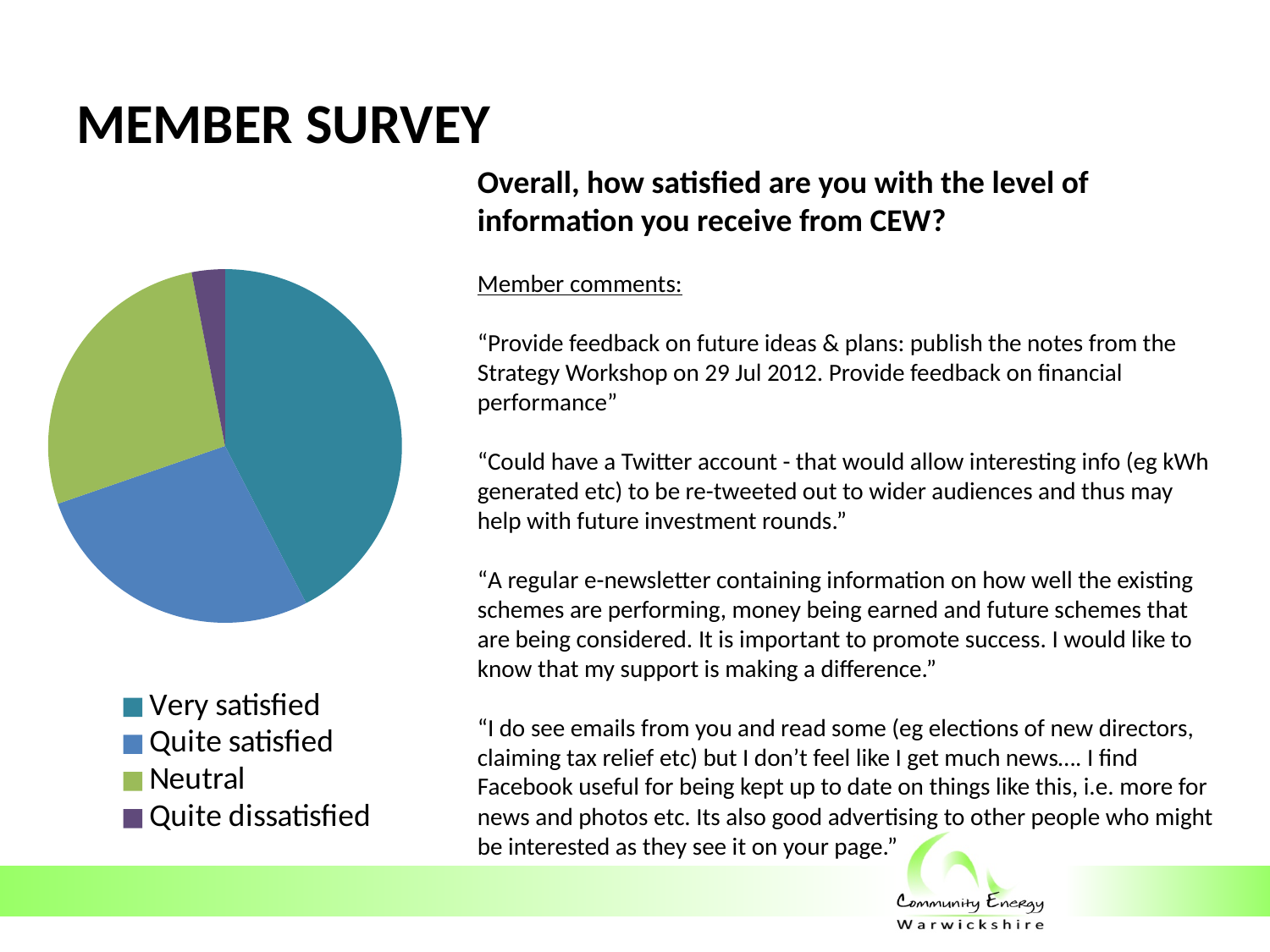
Which category has the largest slice of the pie chart? Very satisfied Which slice is larger, Neutral or Quite dissatisfied? Neutral Which category has the smallest slice of the pie chart? Quite dissatisfied Which slice is larger, Very satisfied or Quite satisfied? Very satisfied Which category is shown in green in the pie chart? Neutral What kind of chart is shown on the slide? Pie chart Which slice is larger, Very satisfied or Neutral? Very satisfied What survey question does the pie chart relate to? Overall, how satisfied are you with the level of information you receive from CEW? How many categories does the pie chart show? 4